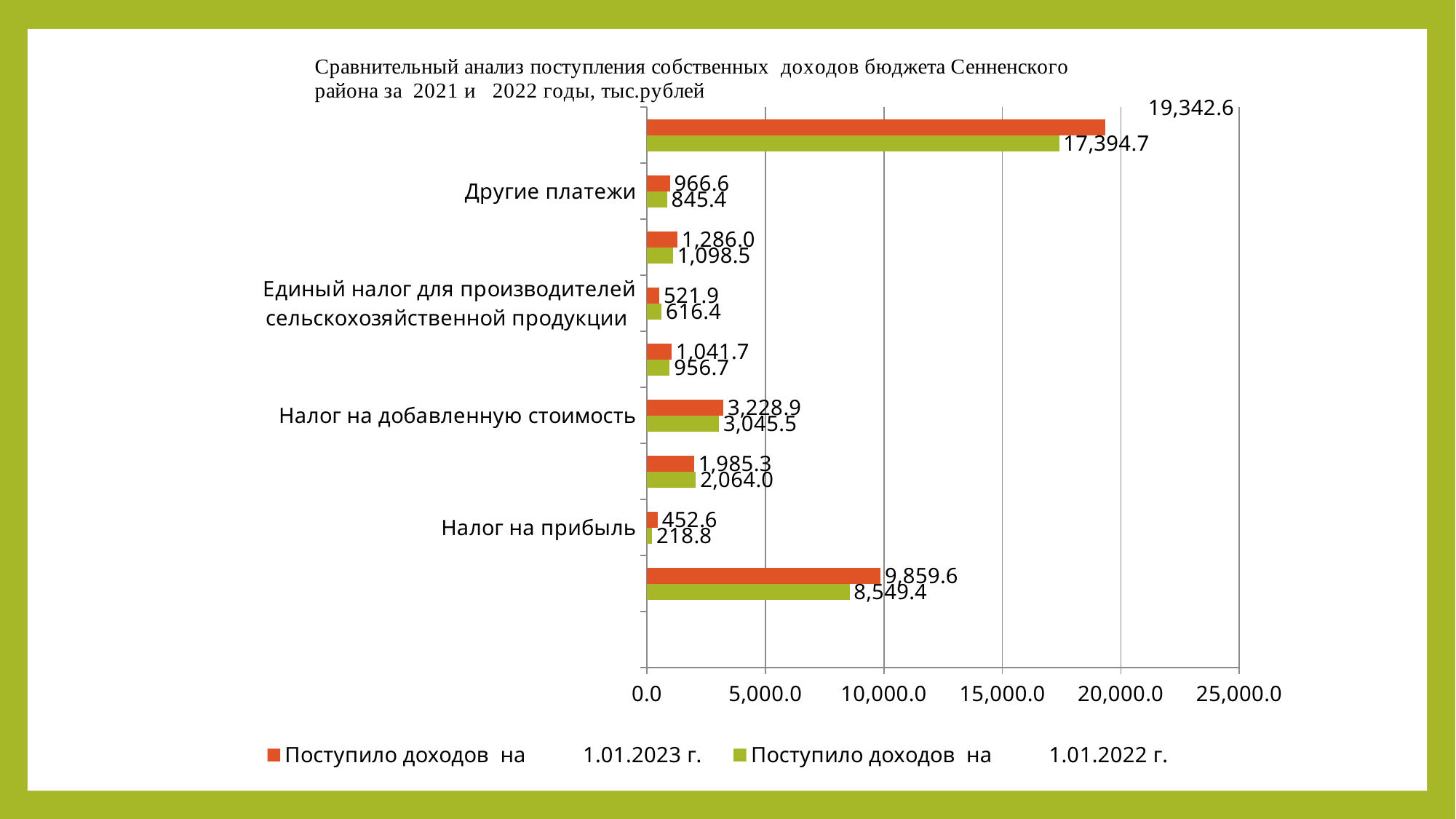
How many category groups (pairs of bars) are plotted in the chart? 9 For 'Единый налог для производителей сельскохозяйственной продукции', which series has the larger value: 1.01.2023 г. or 1.01.2022 г.? 1.01.2022 г. How many series does the legend list? 2 Which colour represents the series 'Поступило доходов на 1.01.2022 г.'? Green What type of chart is shown on the slide? Bar chart What is the difference between the 1.01.2023 г. and 1.01.2022 г. values for 'Налог на добавленную стоимость'? 183.4 What is the value for 'Единый налог для производителей сельскохозяйственной продукции' in the series 'Поступило доходов на 1.01.2022 г.'? 616.4 What is the value for 'Другие платежи' in the series 'Поступило доходов на 1.01.2022 г.'? 845.4 What is the value for 'Налог на прибыль' in the series 'Поступило доходов на 1.01.2022 г.'? 218.8 What is the difference between the 1.01.2023 г. and 1.01.2022 г. values for 'Налог на прибыль'? 233.8 What is the value for 'Налог на добавленную стоимость' in the series 'Поступило доходов на 1.01.2023 г.'? 3,228.9 What is the value for 'Другие платежи' in the series 'Поступило доходов на 1.01.2023 г.'? 966.6